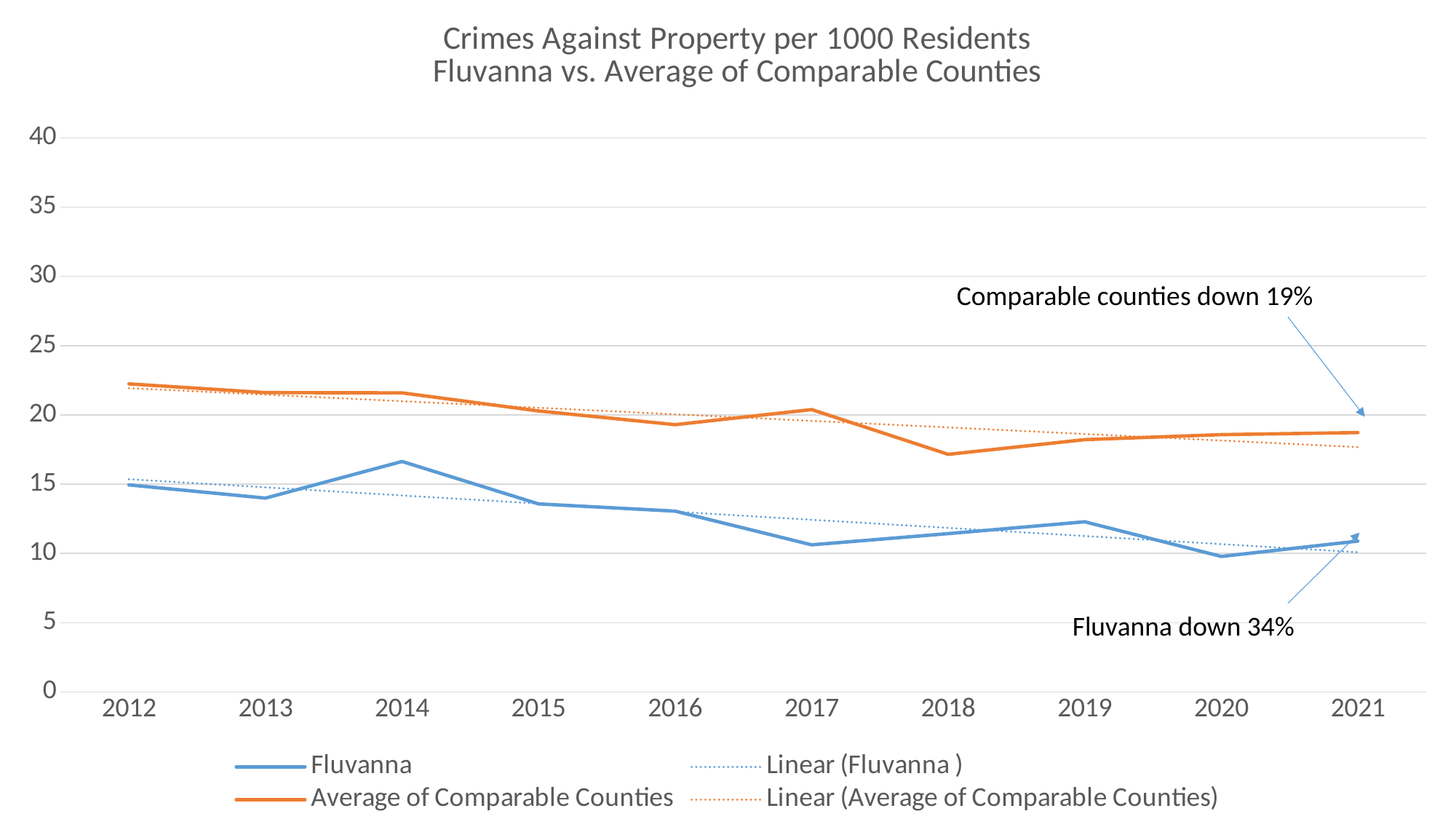
In which year is the Average of Comparable Counties line at its highest? 2012 Is the value for Average of Comparable Counties in 2012 greater or less than 20? greater In which year does the Fluvanna line reach its highest value? 2014 Overall, do the Fluvanna values rise or fall from 2012 to 2021? fall In which year is the Average of Comparable Counties line at its lowest? 2018 According to the annotation on the chart, by what percentage is Fluvanna down? 34% Which series has the higher value in 2021, Fluvanna or Average of Comparable Counties? Average of Comparable Counties How many entries does the legend list? 4 What kind of chart is shown on the slide? line chart How many years are plotted along the x axis? 10 In which year does the Fluvanna line reach its lowest value? 2020